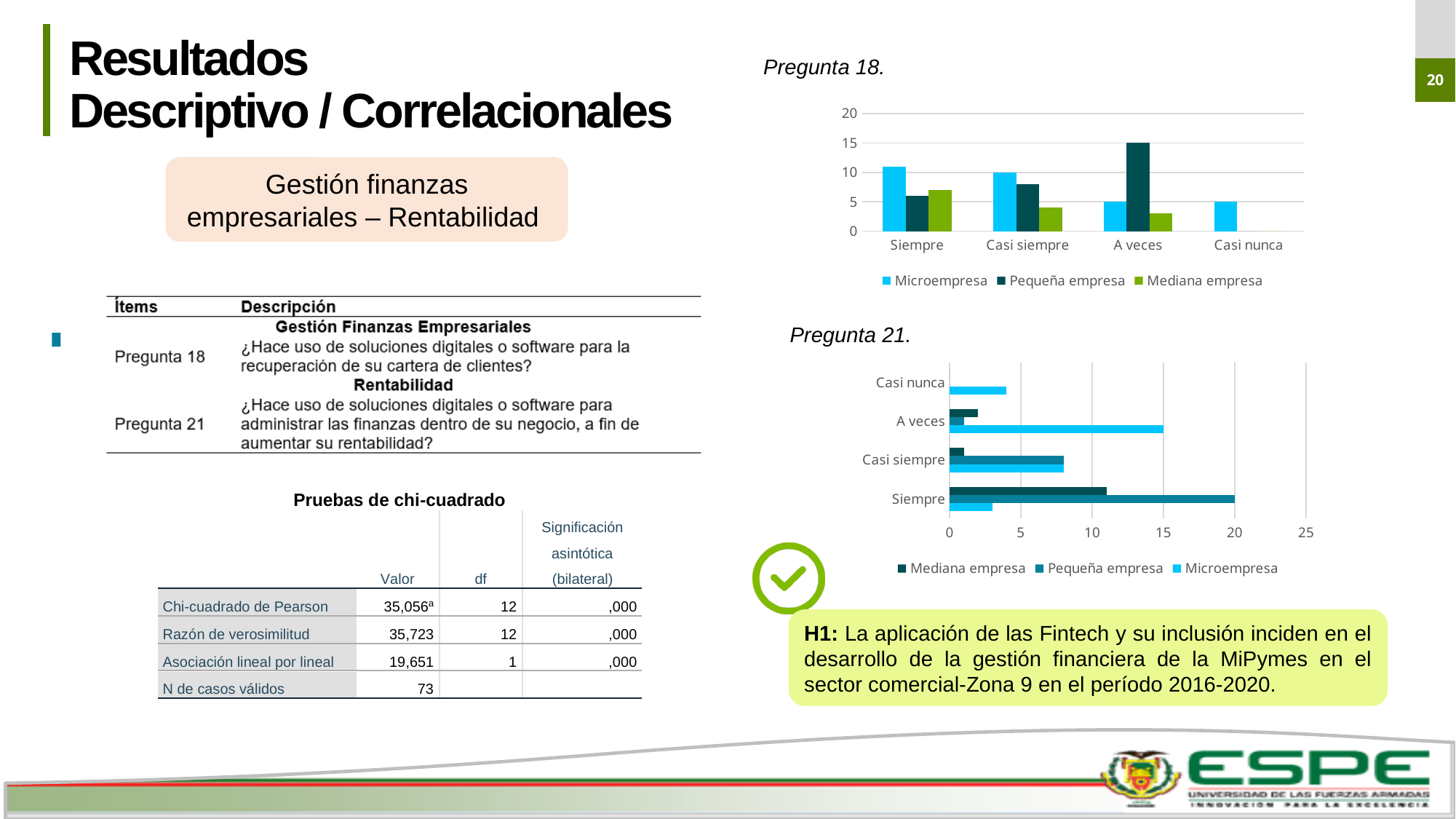
How many series does the legend of the Pregunta 21 chart list? 3 How many categories are shown on the x axis of the Pregunta 18 chart? 4 In the Pregunta 18 chart, which category has the tallest bar for Pequeña empresa? A veces In the Pregunta 18 chart, is the value for Mediana empresa in the Casi siempre category greater or less than 5? less In the Pregunta 18 chart, for the Siempre category, which is larger: Microempresa or Pequeña empresa? Microempresa What kind of chart is the Pregunta 18 chart? bar chart In the Pregunta 18 chart, what is the value for Pequeña empresa in the A veces category? 15 What kind of chart is the Pregunta 21 chart? bar chart In the Pregunta 18 chart, which series has the only bar in the Casi nunca category? Microempresa In the Pregunta 21 chart, which category has the longest bar for Pequeña empresa? Siempre In the Pregunta 21 chart, is the value for Microempresa in the A veces category greater or less than 10? greater How many series does the legend of the Pregunta 18 chart list? 3